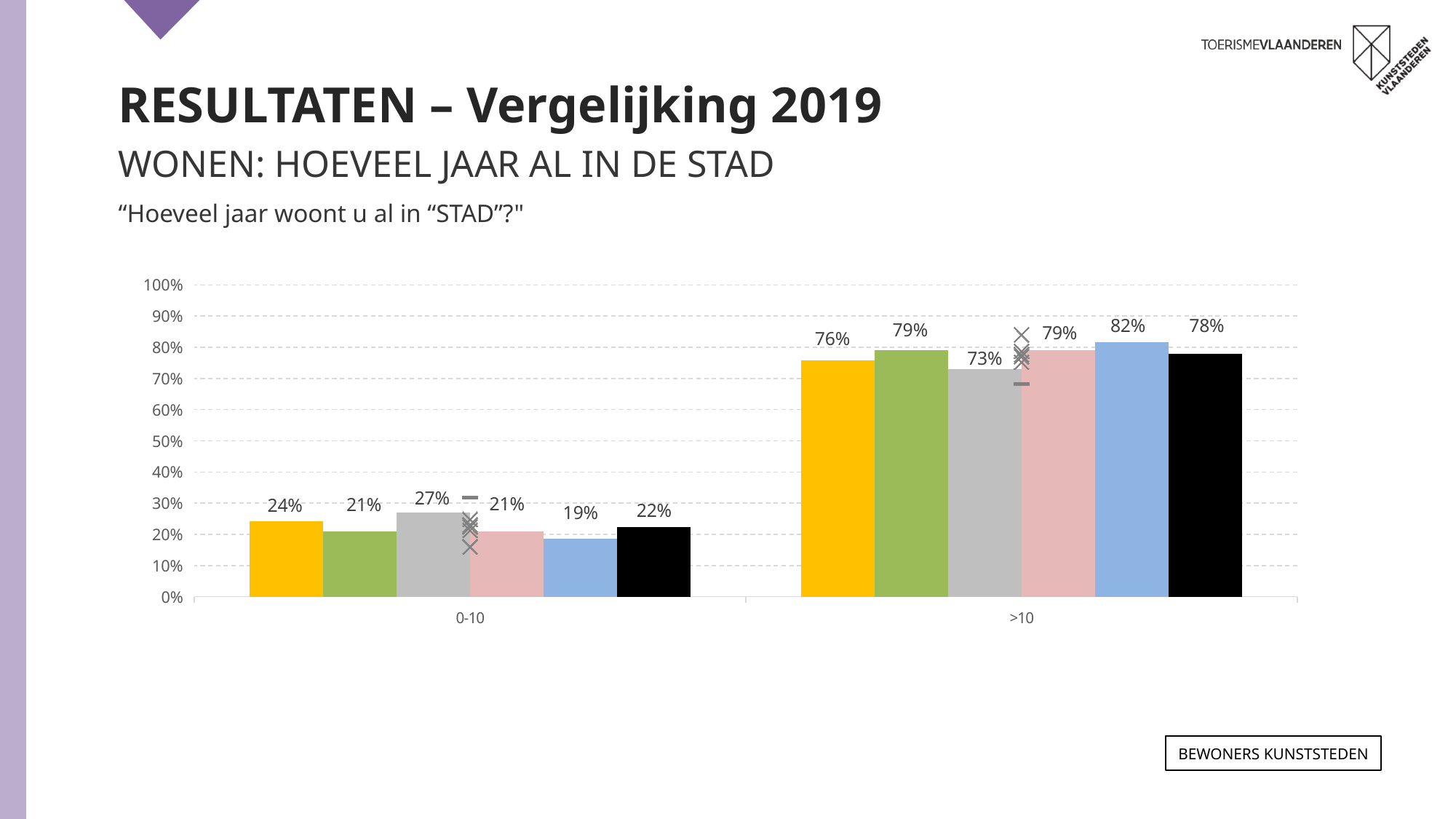
What is the difference between the blue bar and the grey bar in the ">10" category? 9 percentage points Which bar has the lowest value in the ">10" category? the grey bar (73%) What is the value of the blue bar in the ">10" category? 82% Which is larger in the "0-10" category: the yellow bar or the blue bar? the yellow bar Which bar has the highest value in the "0-10" category? the grey bar (27%) What kind of chart is shown on the slide? bar chart What is the value of the black bar in the "0-10" category? 22% How many categories are shown on the x axis of the chart? 2 Is the value of the black bar in the ">10" category greater or less than 70%? greater What is the value of the grey bar in the ">10" category? 73% What is the value of the yellow bar in the "0-10" category? 24% How many bars are plotted in the ">10" category? 6